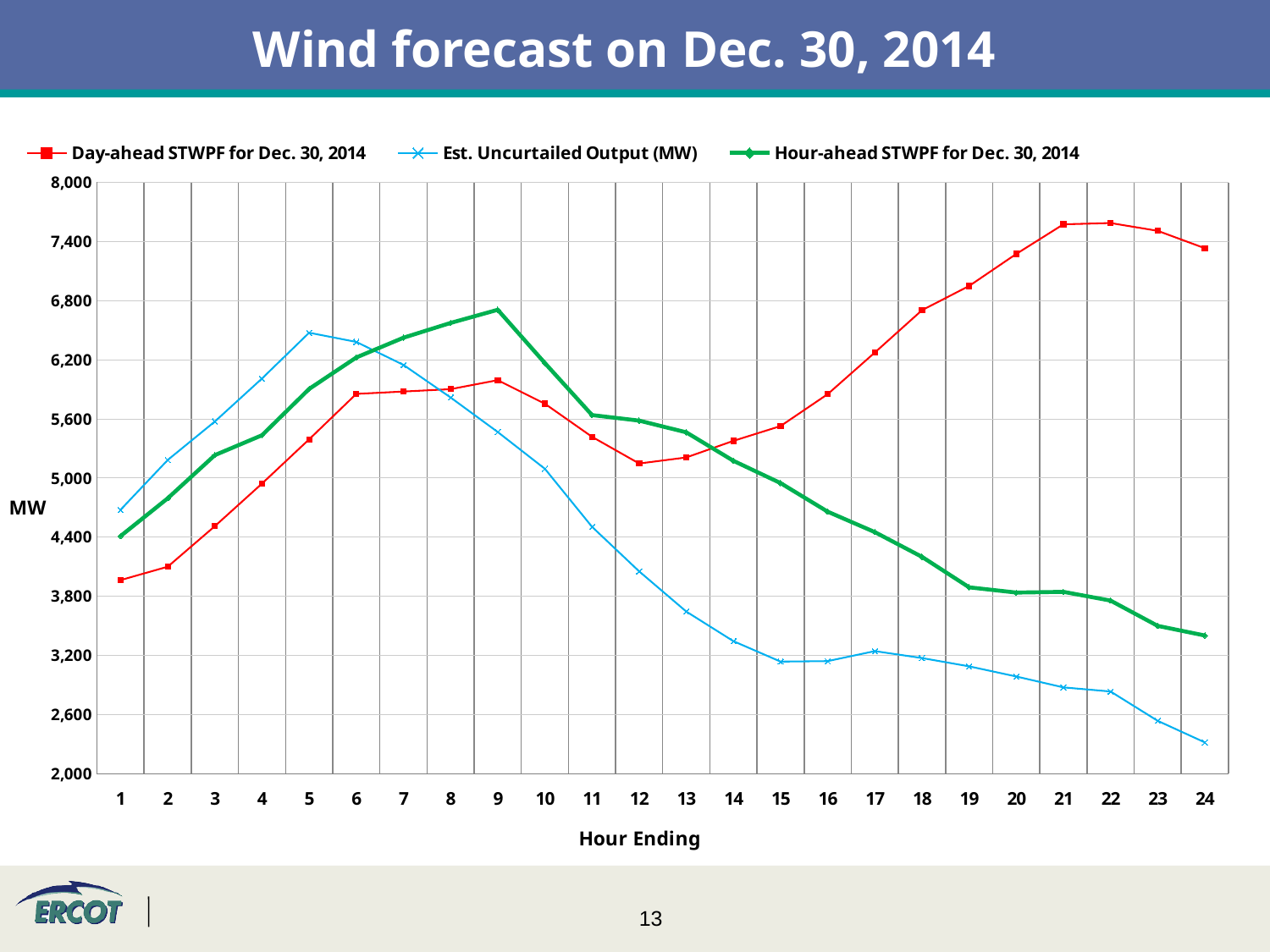
Does the Est. Uncurtailed Output (MW) series rise or fall from hour ending 9 to hour ending 24? fall At which hour ending is the Est. Uncurtailed Output (MW) series at its lowest value? 24 How many hour-ending points are plotted along the x axis? 24 Is the Est. Uncurtailed Output value at hour ending 24 greater or less than 2,600? less At which hour ending is the Day-ahead STWPF for Dec. 30, 2014 series at its lowest value? 1 What kind of chart is shown on the slide? line chart At hour ending 12, which is larger: the Day-ahead STWPF or the Hour-ahead STWPF? Hour-ahead STWPF What is the title of the x axis? Hour Ending How many series does the legend list? 3 At which hour ending does the Hour-ahead STWPF for Dec. 30, 2014 series reach its highest value? 9 Is the Hour-ahead STWPF value at hour ending 24 greater or less than 3,200? greater Is the Day-ahead STWPF value at hour ending 21 greater or less than 7,400? greater